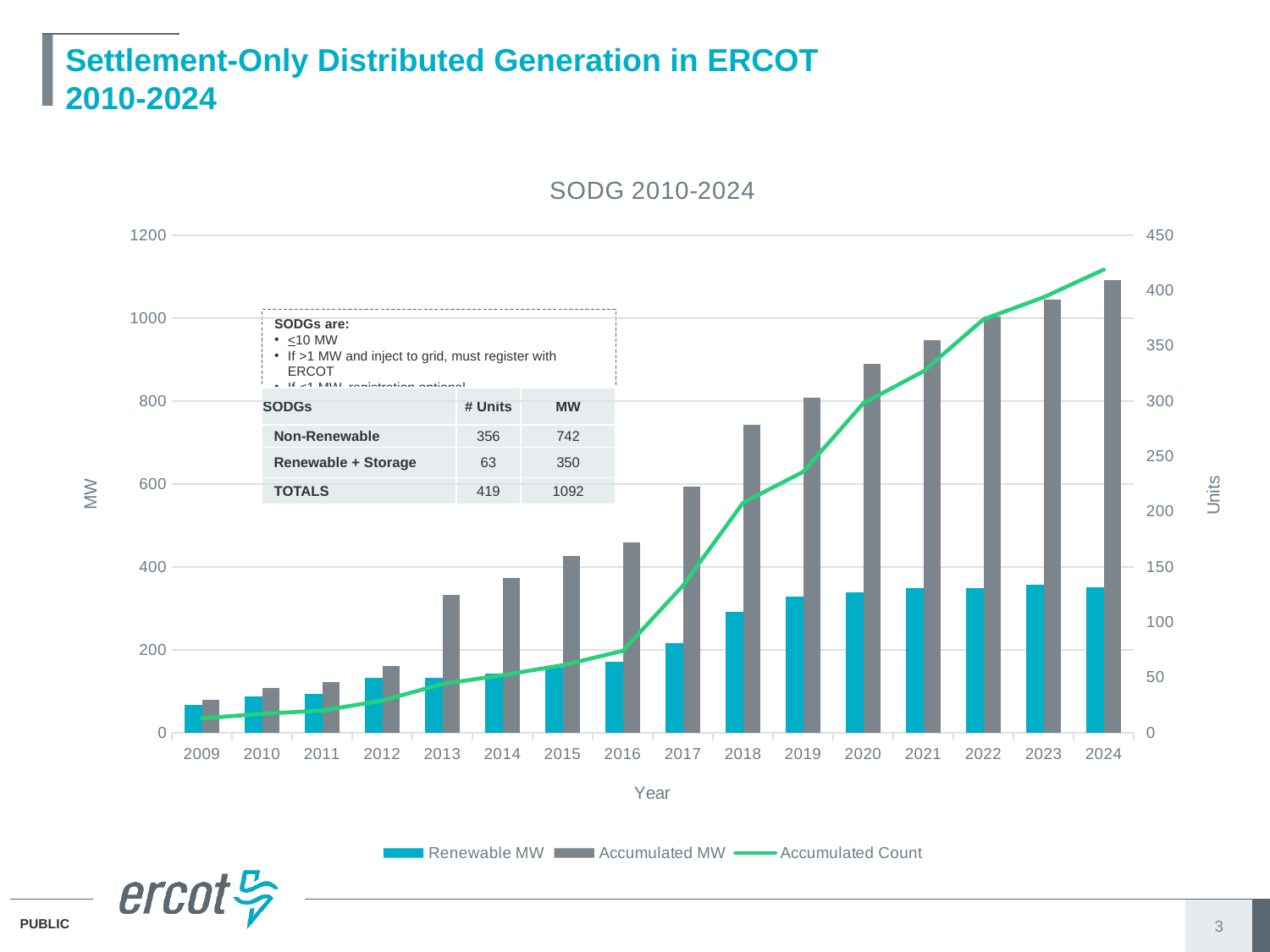
Is the Accumulated Count value for 2024 greater or less than 400 units? greater Is the Accumulated MW value for 2016 greater or less than 400? greater In which year is the Accumulated MW bar highest? 2024 In which year is the Accumulated MW bar lowest? 2009 Does the Accumulated MW series rise or fall from 2009 to 2024? Rise How many years are shown on the x axis of the chart? 16 How many series does the chart legend list? 3 What kind of chart is shown on the slide? A combined bar and line chart Is the Renewable MW value for 2024 greater or less than 400? less In 2024, which is larger: the Accumulated MW bar or the Renewable MW bar? Accumulated MW What is the title of the chart? SODG 2010-2024